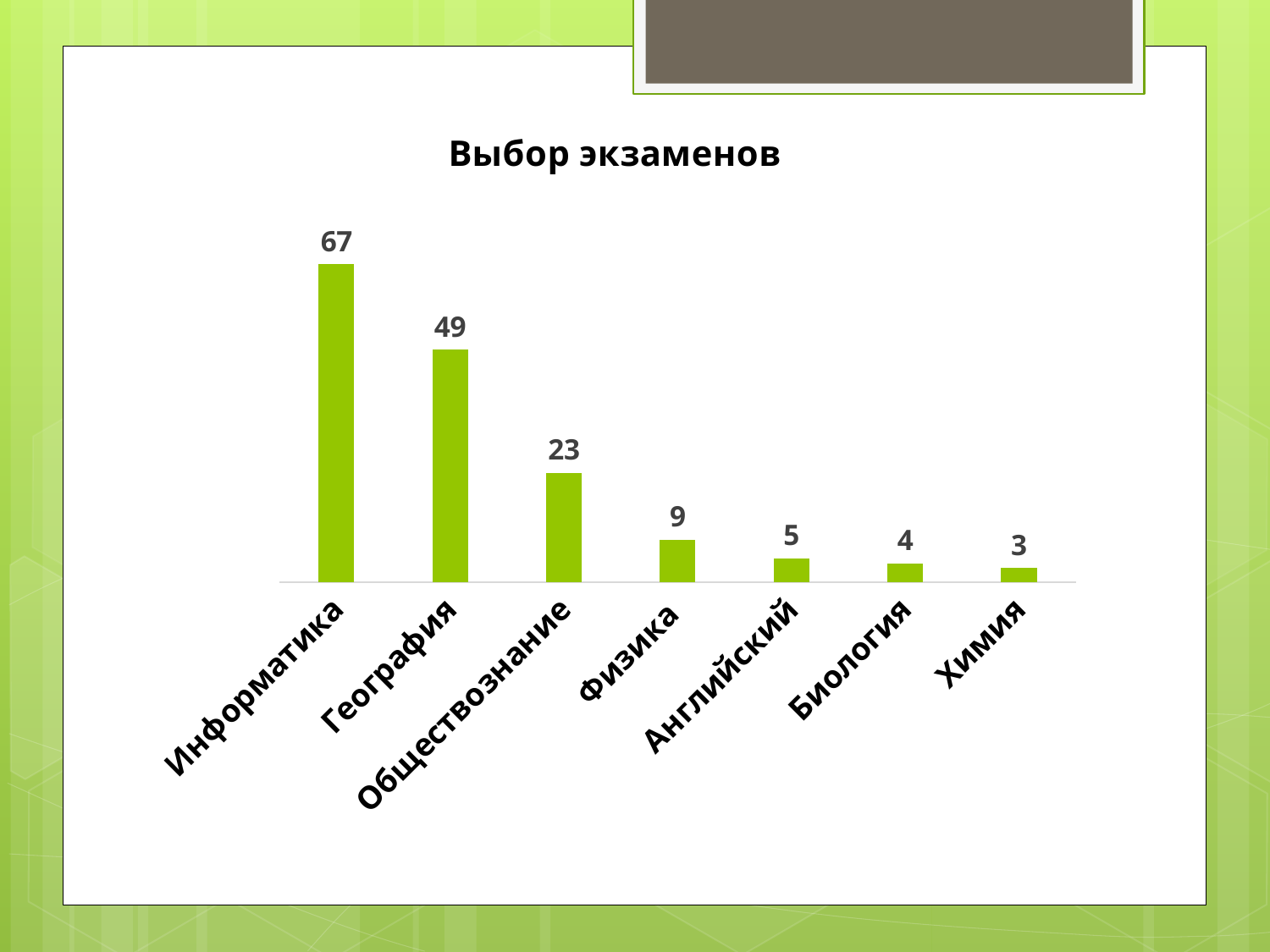
How many categories are shown in the chart? 7 Which is larger, the value for Английский or the value for Биология? Английский What is the difference between the values for Информатика and География? 18 Which category has the lowest value? Химия What kind of chart is shown on the slide? Bar chart What is the title of the chart? Выбор экзаменов Which category has the highest value? Информатика What is the value for География? 49 What is the value for Информатика? 67 What is the difference between the values for Обществознание and Физика? 14 What is the value for Обществознание? 23 What is the value for Химия? 3